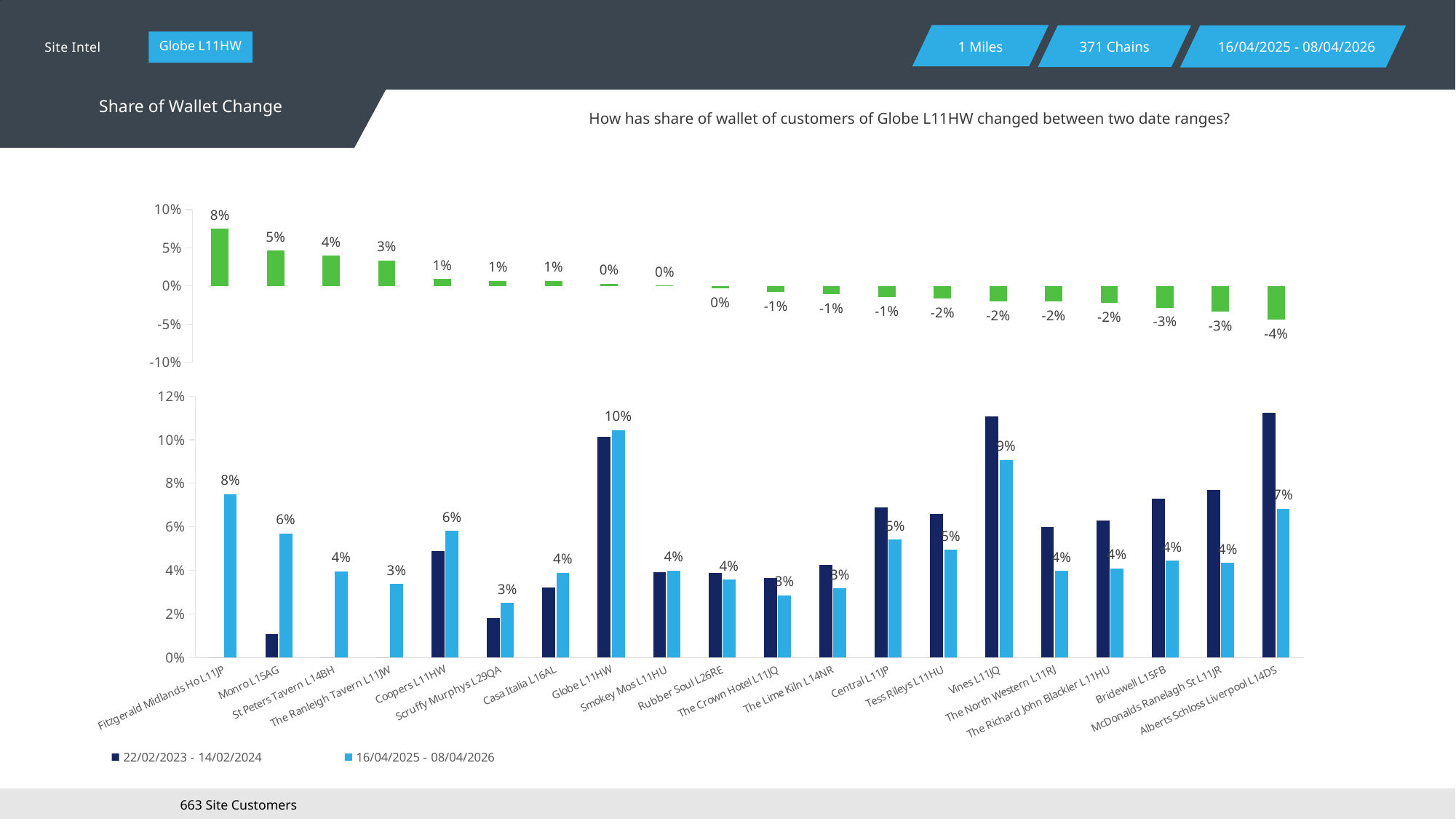
In the top chart, what is the share of wallet change for Fitzgerald Midlands Ho L11JP? 8% In the top chart, what is the value for Alberts Schloss Liverpool L14DS? -4% In the top chart, which category has the highest share of wallet change? Fitzgerald Midlands Ho L11JP How many categories are shown on the x axis of the bottom chart? 20 In the bottom chart, what is the value for Vines L11JQ in the 16/04/2025 - 08/04/2026 series? 9% In the bottom chart, is the 22/02/2023 - 14/02/2024 value for Monro L15AG greater or less than 2%? less In the top chart, which category has the lowest share of wallet change? Alberts Schloss Liverpool L14DS How many series does the legend of the bottom chart list? 2 In the top chart, what is the difference between the values for Monro L15AG and The Ranleigh Tavern L11JW? 2% In the bottom chart, what is the value for Globe L11HW in the 16/04/2025 - 08/04/2026 series? 10% In the bottom chart, which is larger for Coopers L11HW: the 22/02/2023 - 14/02/2024 value or the 16/04/2025 - 08/04/2026 value? 16/04/2025 - 08/04/2026 In the bottom chart, is the 22/02/2023 - 14/02/2024 value for Vines L11JQ greater or less than 10%? greater